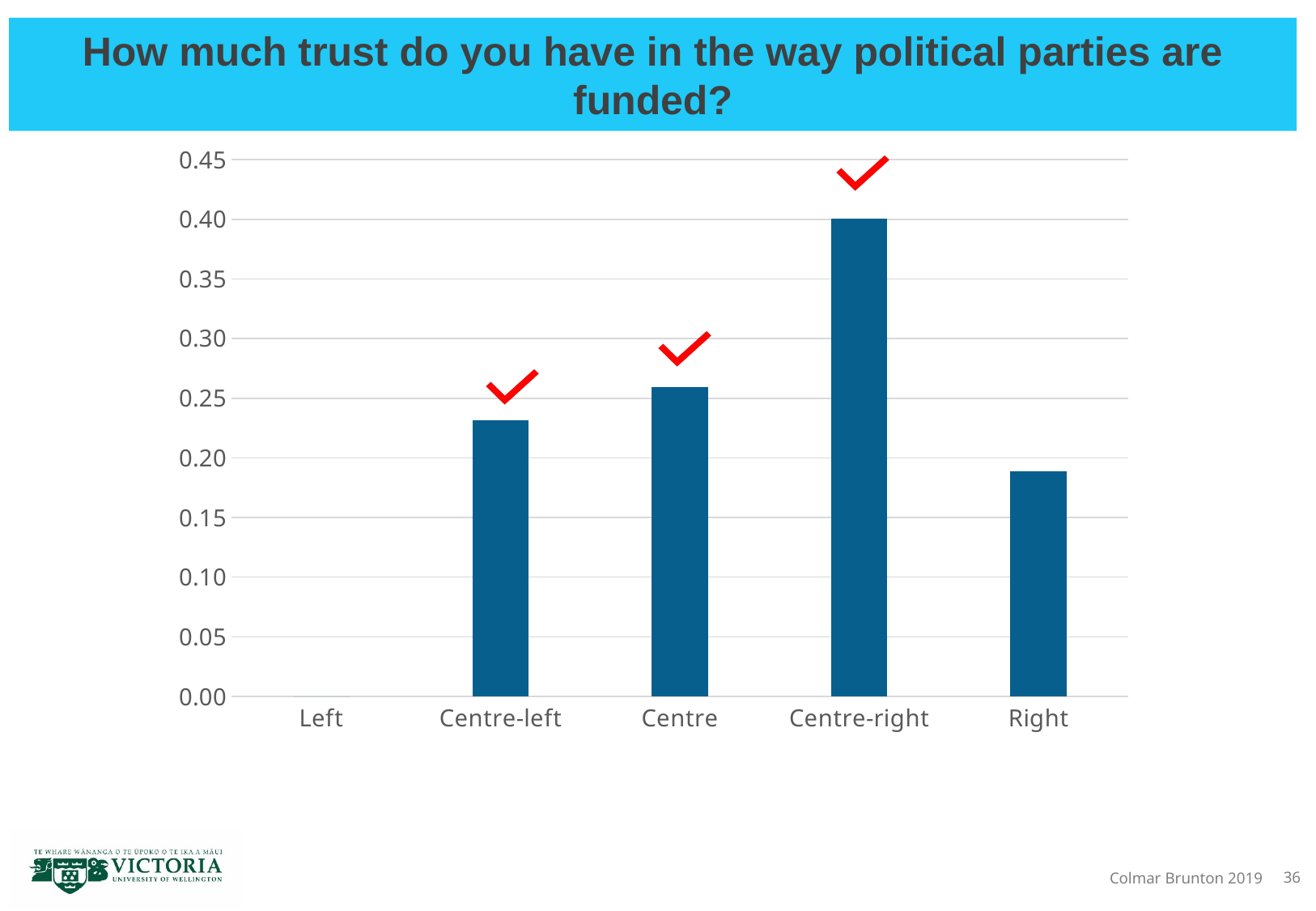
What is the value for Centre-right? 0.40 Is the value for Centre-right greater or less than 0.35? greater Is the value for Right greater or less than 0.20? less Is the value for Centre-left greater or less than 0.25? less Which has the larger value, Centre-right or Right? Centre-right Which category has the highest value in the chart? Centre-right Which category has the lowest value in the chart? Left What is the title of the chart on the slide? How much trust do you have in the way political parties are funded? How many bars in the chart are marked with a red check mark? 3 Which has the larger value, Centre or Centre-left? Centre How many categories are shown on the x axis of the chart? 5 What kind of chart is shown on the slide? bar chart